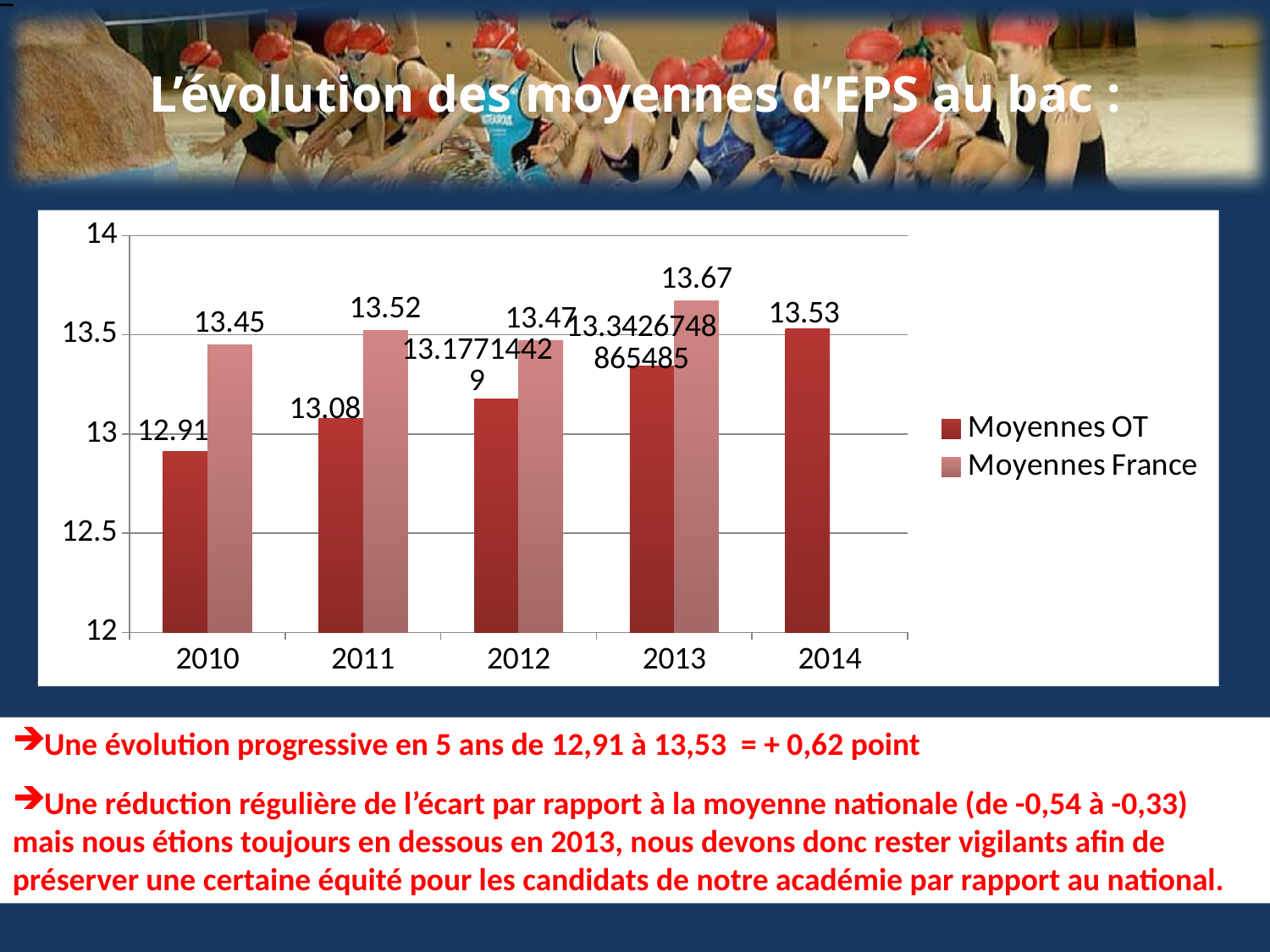
What is the value for Moyennes France in 2011? 13.52 Is the value for Moyennes OT in 2012 greater or less than 13? greater What is the value for Moyennes OT in 2014? 13.53 How many years are shown on the x axis? 5 In which year is Moyennes France highest? 2013 What is the difference between Moyennes OT in 2014 and Moyennes OT in 2010? 0.62 What is the value for Moyennes France in 2013? 13.67 Which is larger in 2010, Moyennes OT or Moyennes France? Moyennes France In which year is Moyennes OT lowest? 2010 How many series does the legend list? 2 Does Moyennes OT rise or fall from 2010 to 2014? rise What is the value for Moyennes OT in 2010? 12.91